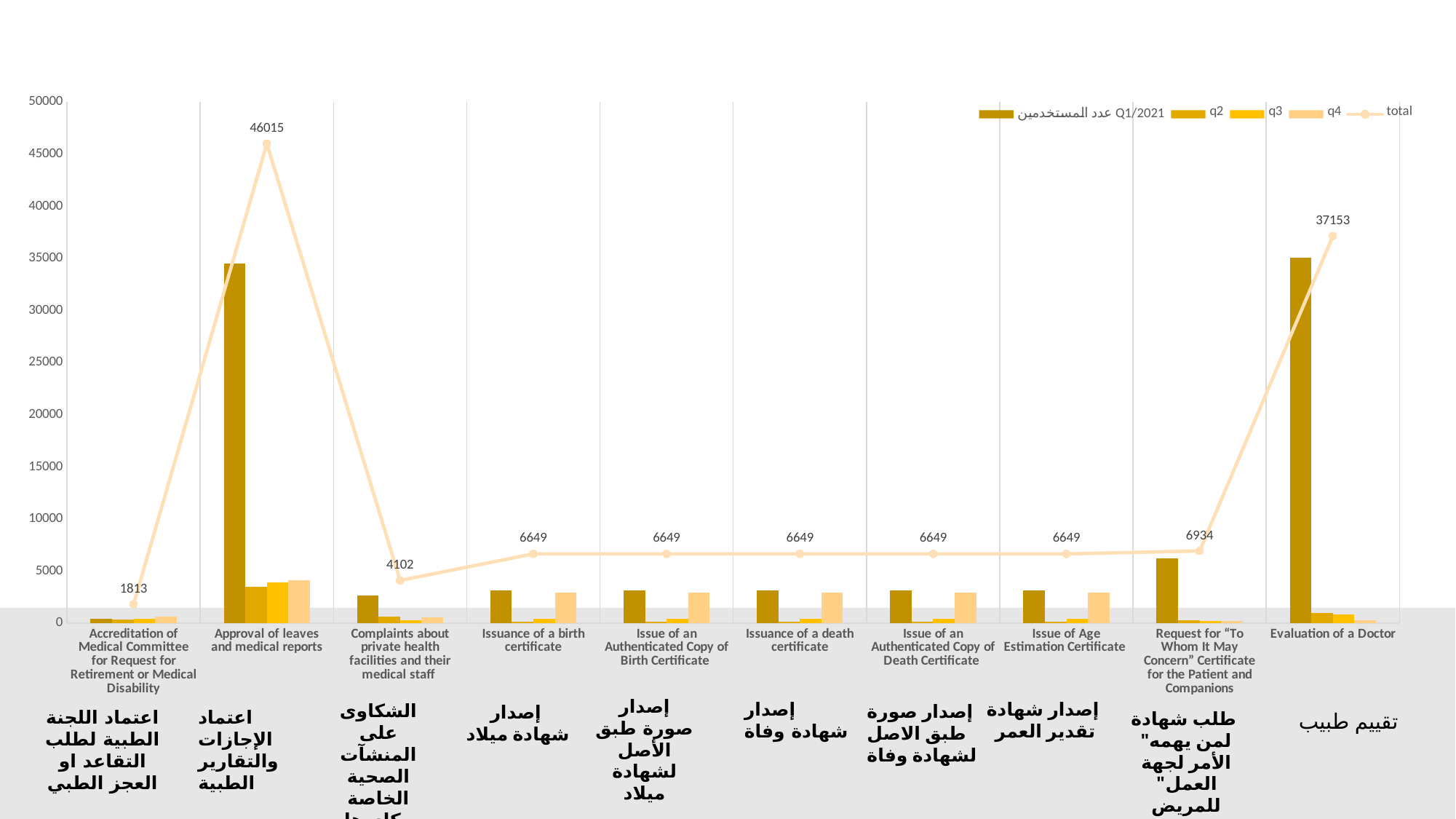
What is the total value for Complaints about private health facilities and their medical staff? 4102 How many series does the legend list? 5 Is the Q1/2021 bar for Evaluation of a Doctor greater or less than 30000? greater What is the total value for Approval of leaves and medical reports? 46015 Which has a larger total value, Issuance of a birth certificate or Request for "To Whom It May Concern" Certificate for the Patient and Companions? Request for "To Whom It May Concern" Certificate for the Patient and Companions Which category has the lowest total value? Accreditation of Medical Committee for Request for Retirement or Medical Disability What is the total value for Request for "To Whom It May Concern" Certificate for the Patient and Companions? 6934 How many categories are shown on the x axis? 10 What kind of chart is this? Combined bar and line chart What is the total value for Evaluation of a Doctor? 37153 Which category has the highest total value? Approval of leaves and medical reports What is the difference between the total values for Approval of leaves and medical reports and Evaluation of a Doctor? 8862